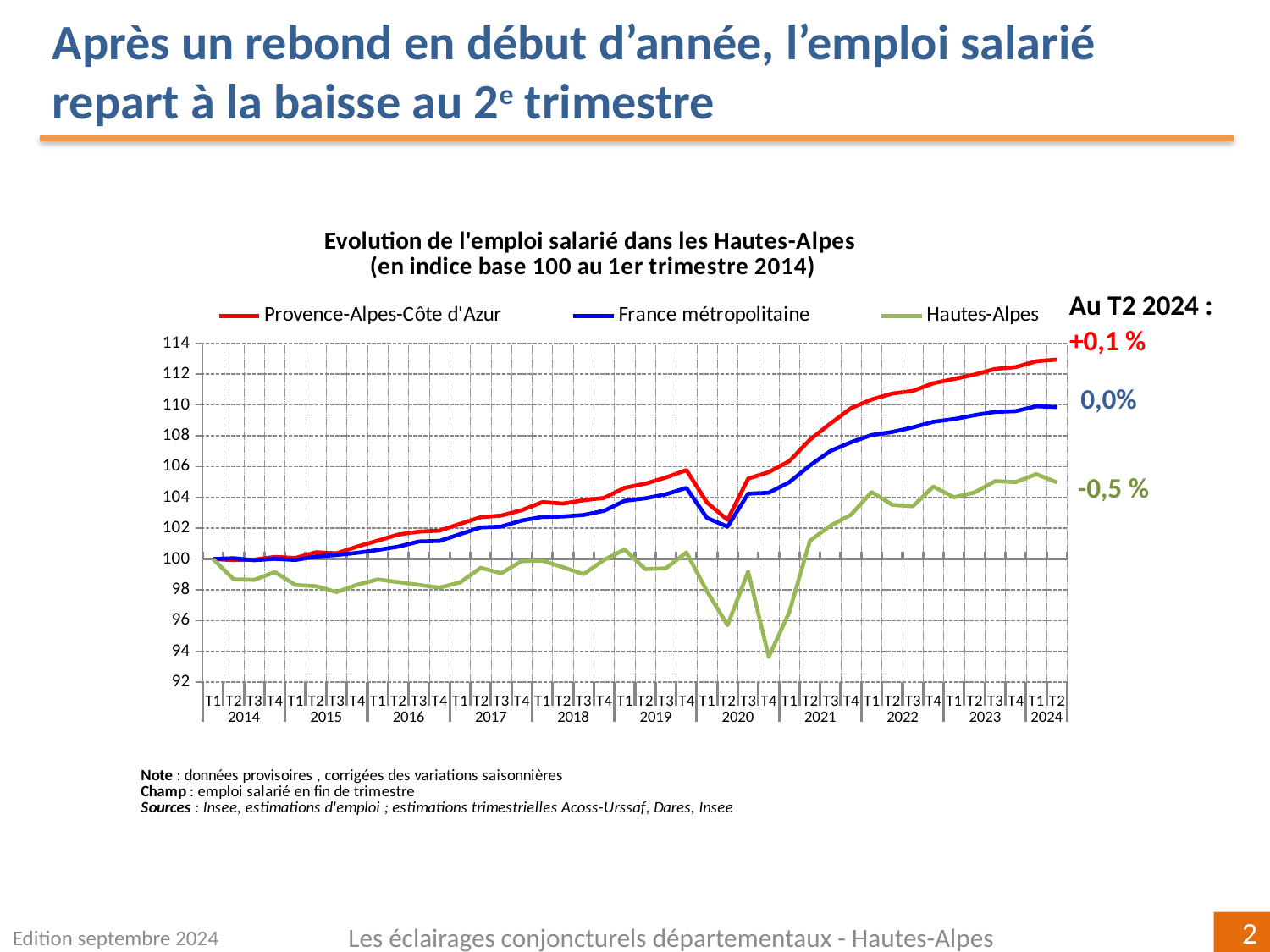
How many series does the legend list? 3 Which series is drawn in green? Hautes-Alpes What change is annotated for Provence-Alpes-Côte d'Azur at T2 2024? +0,1 % Which series has the lowest value at T4 2020? Hautes-Alpes What is the title of the chart? Evolution de l'emploi salarié dans les Hautes-Alpes (en indice base 100 au 1er trimestre 2014) Is the value for Hautes-Alpes at T4 2020 greater or less than 96? less At T2 2024, which is higher: Provence-Alpes-Côte d'Azur or Hautes-Alpes? Provence-Alpes-Côte d'Azur What change is annotated for France métropolitaine at T2 2024? 0,0% Is the value for Provence-Alpes-Côte d'Azur at T2 2024 greater or less than 112? greater Does the Provence-Alpes-Côte d'Azur series rise or fall from T1 2021 to T2 2024? rise What kind of chart is shown on the slide? line chart What change is annotated for Hautes-Alpes at T2 2024? -0,5 %